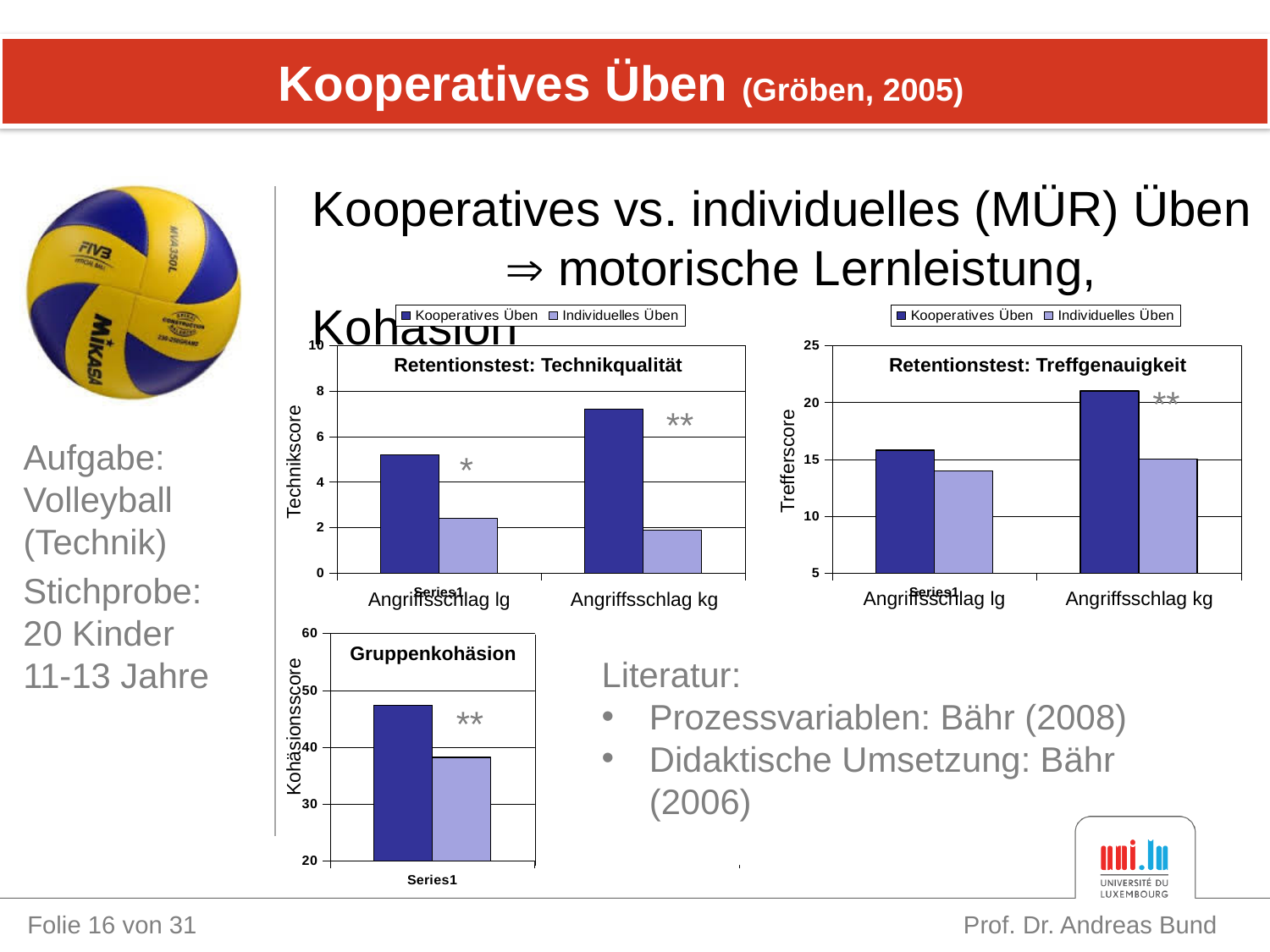
In the chart titled "Gruppenkohäsion", which bar is taller, the dark blue bar or the light blue bar? the dark blue bar In the chart titled "Retentionstest: Technikqualität", which bar is the tallest? Kooperatives Üben at Angriffsschlag kg In the chart titled "Gruppenkohäsion", is the value of the dark blue bar greater or less than 40? greater In the chart titled "Retentionstest: Treffgenauigkeit", which series has the higher value at Angriffsschlag kg, Kooperatives Üben or Individuelles Üben? Kooperatives Üben In the chart titled "Retentionstest: Treffgenauigkeit", is the value for Individuelles Üben at Angriffsschlag lg greater or less than 15? less What kind of chart is the chart titled "Gruppenkohäsion"? bar chart In the chart titled "Retentionstest: Technikqualität", which series has the higher value at Angriffsschlag lg, Kooperatives Üben or Individuelles Üben? Kooperatives Üben In the chart titled "Retentionstest: Technikqualität", is the value for Individuelles Üben at Angriffsschlag lg greater or less than 4? less In the chart titled "Retentionstest: Technikqualität", how many series does the legend list? 2 In the chart titled "Retentionstest: Treffgenauigkeit", how many categories are shown on the x axis? 2